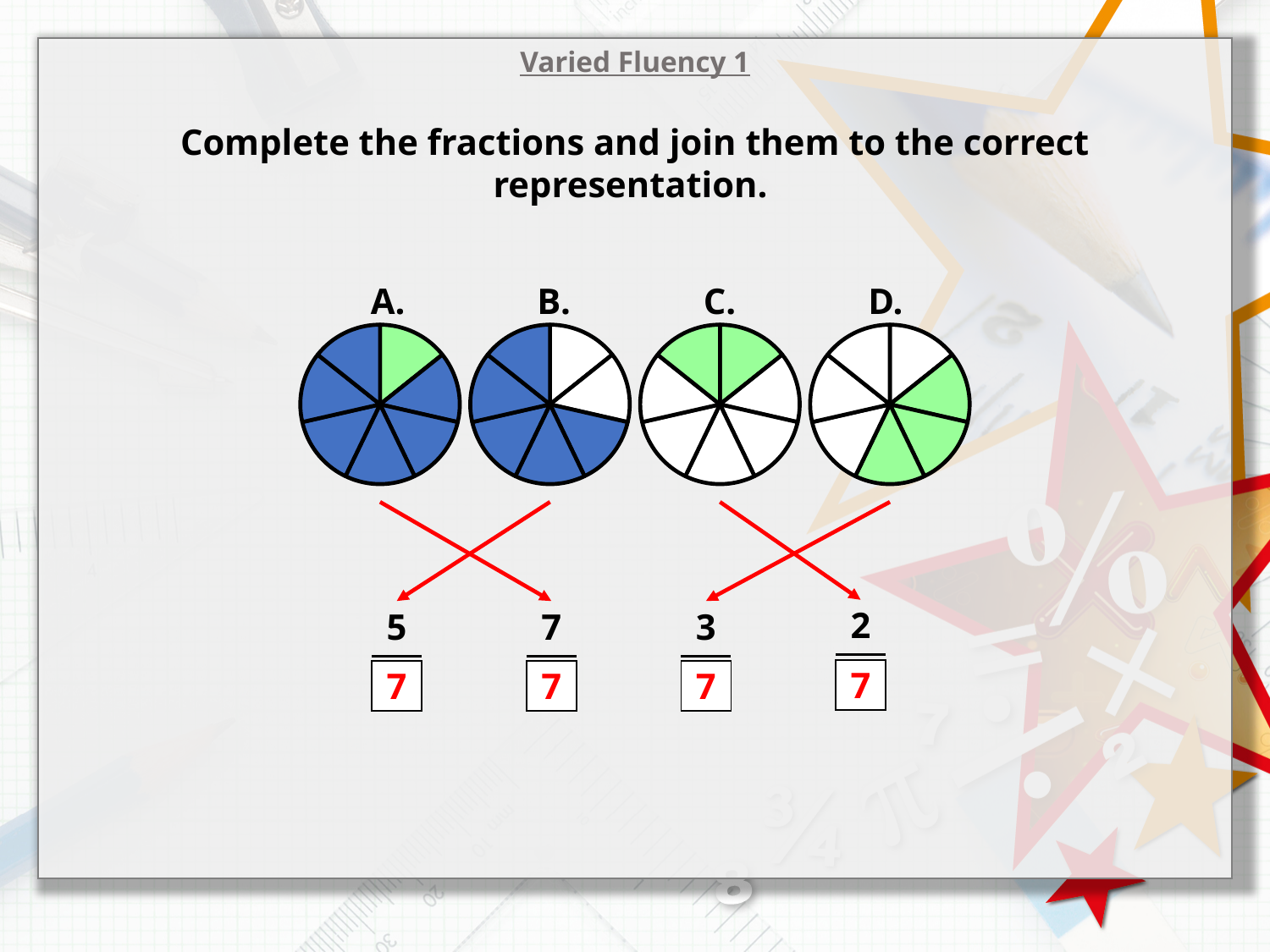
Which fraction does the arrow from circle A point to? 7/7 How many parts of circle B are shaded blue? 5 How many parts of circle C are shaded green? 2 Which fraction does the arrow from circle B point to? 5/7 How many parts of circle D are shaded green? 3 Which fraction does the arrow from circle D point to? 3/7 What colour are the shaded parts of circle B? Blue Which circle has more shaded parts, circle B or circle C? Circle B What number is written in each of the red denominator boxes? 7